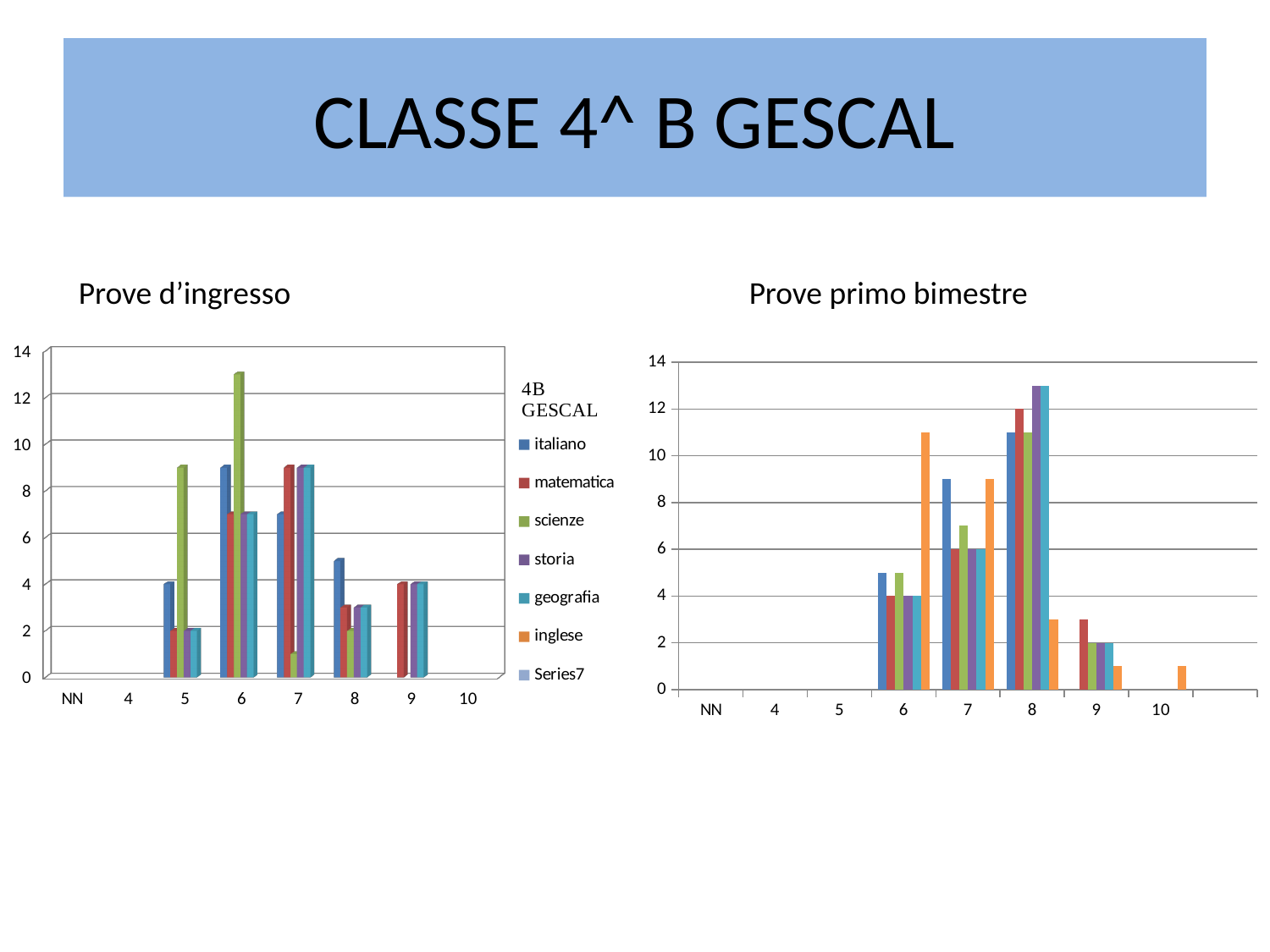
In the Prove d'ingresso chart, at category 5, which is larger: scienze or italiano? scienze In the Prove d'ingresso chart, what is the value for italiano at category 5? 4 In the Prove d'ingresso chart, at which category does scienze reach its highest value? 6 What kind of chart is the Prove primo bimestre chart? bar chart What is the title of the chart on the right side of the slide? Prove primo bimestre How many categories are shown on the x axis of the Prove d'ingresso chart? 8 How many series does the legend of the Prove d'ingresso chart list? 7 In the Prove primo bimestre chart, is the tallest bar at category 6 greater or less than 10? greater In the Prove d'ingresso chart, is the value for scienze at category 6 greater or less than 12? greater What kind of chart is the Prove d'ingresso chart? bar chart In the Prove d'ingresso chart, is the value for matematica at category 7 greater or less than 8? greater How many categories are shown on the x axis of the Prove primo bimestre chart? 8